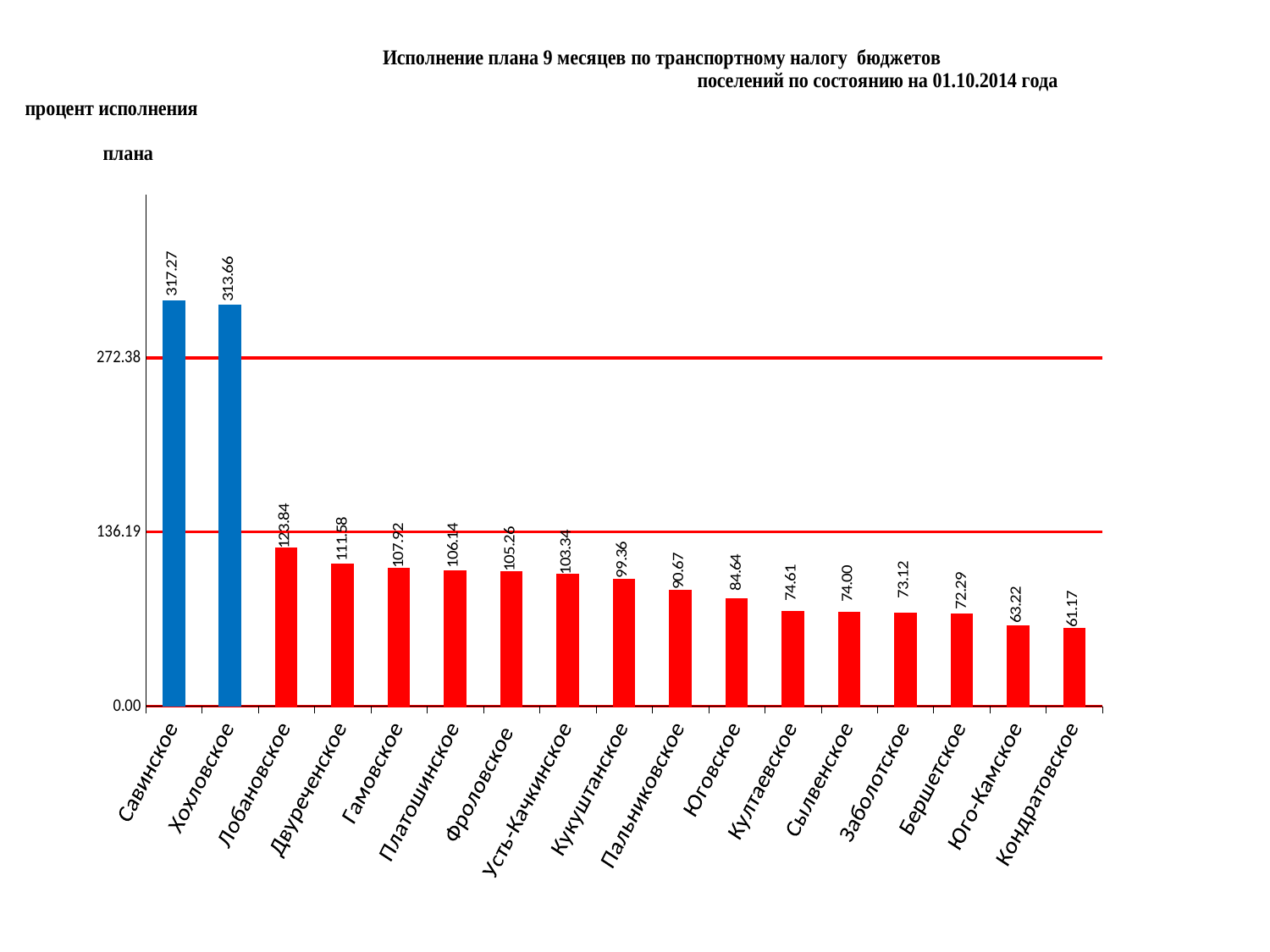
What is the value for Кондратовское? 61.17 What kind of chart is shown on the slide? bar chart Which category has the lowest value? Кондратовское What is the difference between the values for Савинское and Хохловское? 3.61 Do the values rise or fall from left to right along the x axis? fall What is the value for Савинское? 317.27 What is the difference between the values for Лобановское and Двуреченское? 12.26 What is the value for Лобановское? 123.84 Which category has the highest value? Савинское How many categories are shown on the x axis? 17 Which is larger, the value for Юговское or the value for Култаевское? Юговское Is the value for Гамовское greater or less than 136.19? less